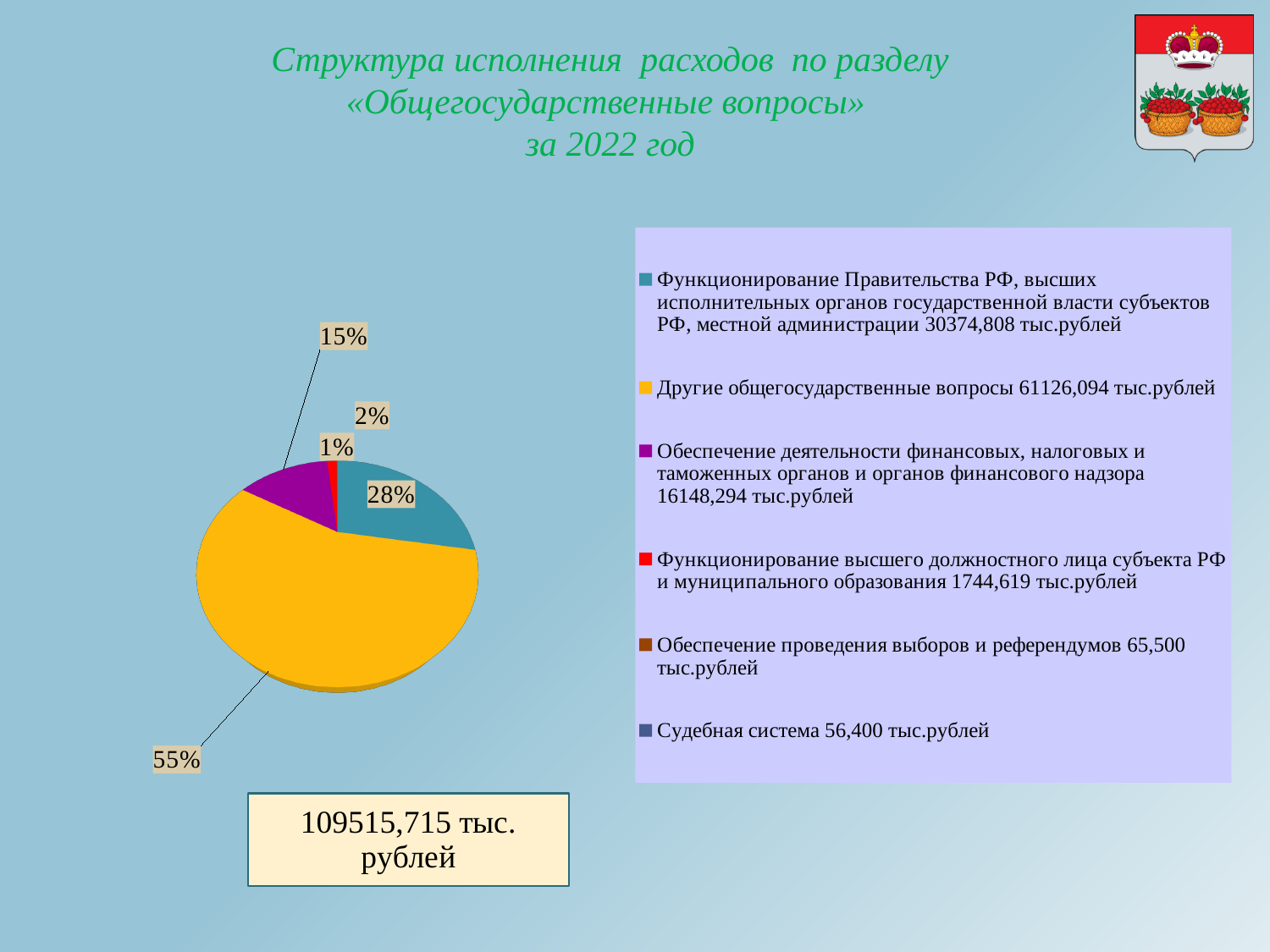
What share of the pie does «Функционирование Правительства РФ, высших исполнительных органов государственной власти субъектов РФ, местной администрации» take? 28% According to the legend, what is the amount for «Другие общегосударственные вопросы»? 61126,094 тыс.рублей How many categories does the legend of the pie chart list? 6 What share of the pie does «Другие общегосударственные вопросы» take? 55% What share of the pie does «Обеспечение деятельности финансовых, налоговых и таможенных органов и органов финансового надзора» take? 15% According to the legend, what is the amount for «Судебная система»? 56,400 тыс.рублей What total amount is shown in the box below the pie chart? 109515,715 тыс. рублей What kind of chart is shown on the slide? pie chart What is the difference between the amounts for «Другие общегосударственные вопросы» and «Функционирование Правительства РФ...» as given in the legend? 30751,286 тыс.рублей According to the legend, what is the amount for «Обеспечение проведения выборов и референдумов»? 65,500 тыс.рублей Which category has the largest slice of the pie chart? Другие общегосударственные вопросы Which is larger: the amount for «Функционирование Правительства РФ...» or for «Обеспечение деятельности финансовых, налоговых и таможенных органов...»? Функционирование Правительства РФ...